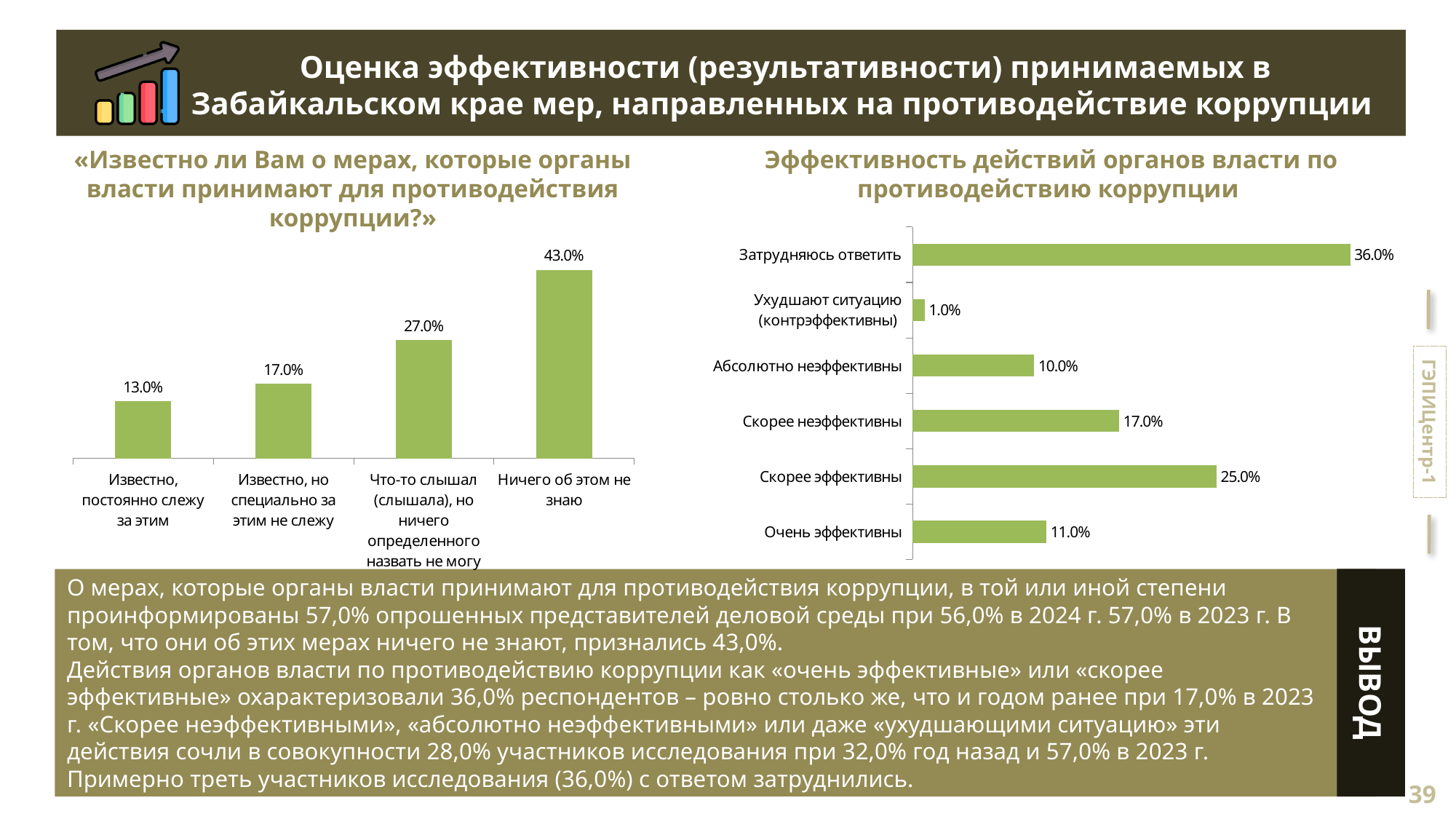
In the right chart («Эффективность действий органов власти по противодействию коррупции»), which category has the highest value? Затрудняюсь ответить How many categories are shown in the right chart («Эффективность действий органов власти по противодействию коррупции»)? 6 In the right chart («Эффективность действий органов власти по противодействию коррупции»), what is the value for «Скорее эффективны»? 25.0% In the right chart («Эффективность действий органов власти по противодействию коррупции»), what is the total of «Очень эффективны» and «Скорее эффективны»? 36.0% How many categories are shown in the left chart («Известно ли Вам о мерах...»)? 4 In the left chart («Известно ли Вам о мерах...»), what is the difference between «Что-то слышал (слышала), но ничего определенного назвать не могу» and «Известно, но специально за этим не слежу»? 10.0% In the right chart («Эффективность действий органов власти по противодействию коррупции»), which is larger: «Очень эффективны» or «Абсолютно неэффективны»? Очень эффективны What type of chart is the left chart («Известно ли Вам о мерах...»)? Bar chart In the right chart («Эффективность действий органов власти по противодействию коррупции»), which category has the lowest value? Ухудшают ситуацию (контрэффективны) In the left chart («Известно ли Вам о мерах...»), what is the value for «Ничего об этом не знаю»? 43.0% In the left chart («Известно ли Вам о мерах...»), which category has the highest value? Ничего об этом не знаю In the left chart («Известно ли Вам о мерах...»), what is the value for «Известно, постоянно слежу за этим»? 13.0%